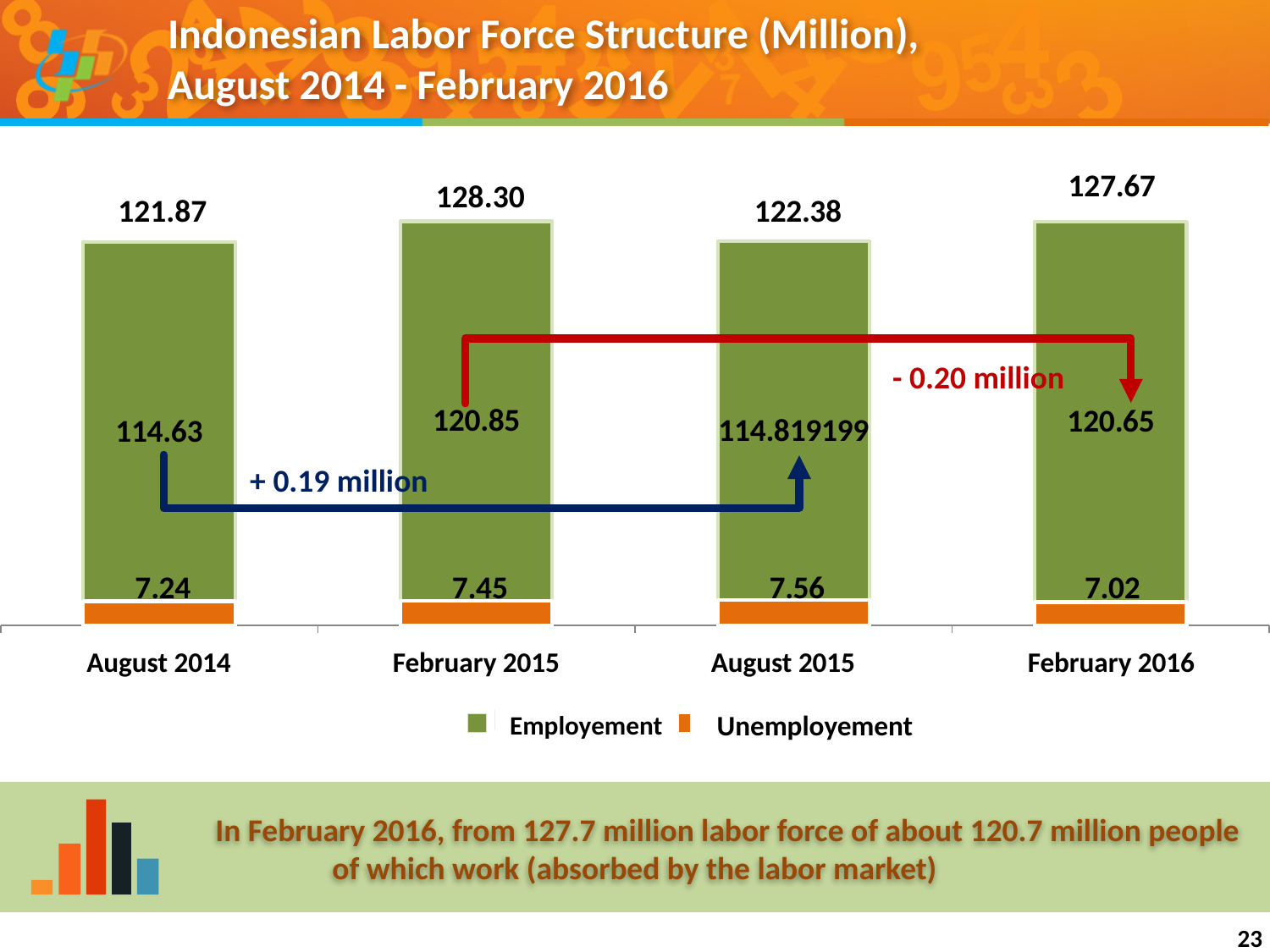
How many series does the legend list? 2 Which period has the highest Unemployment value? August 2015 What is the Unemployment value for August 2015? 7.56 What is the total labor force shown above the bar for February 2016? 127.67 What is the Employment value for August 2015? 114.819199 How many periods are shown on the x axis? 4 Which period has the lowest Unemployment value? February 2016 Is the Employment value larger in August 2014 or February 2016? February 2016 What kind of chart is shown on the slide? Stacked bar chart What is the Employment value for February 2015? 120.85 What is the difference between the Unemployment values for February 2015 and February 2016? 0.43 Which period has the highest total labor force? February 2015